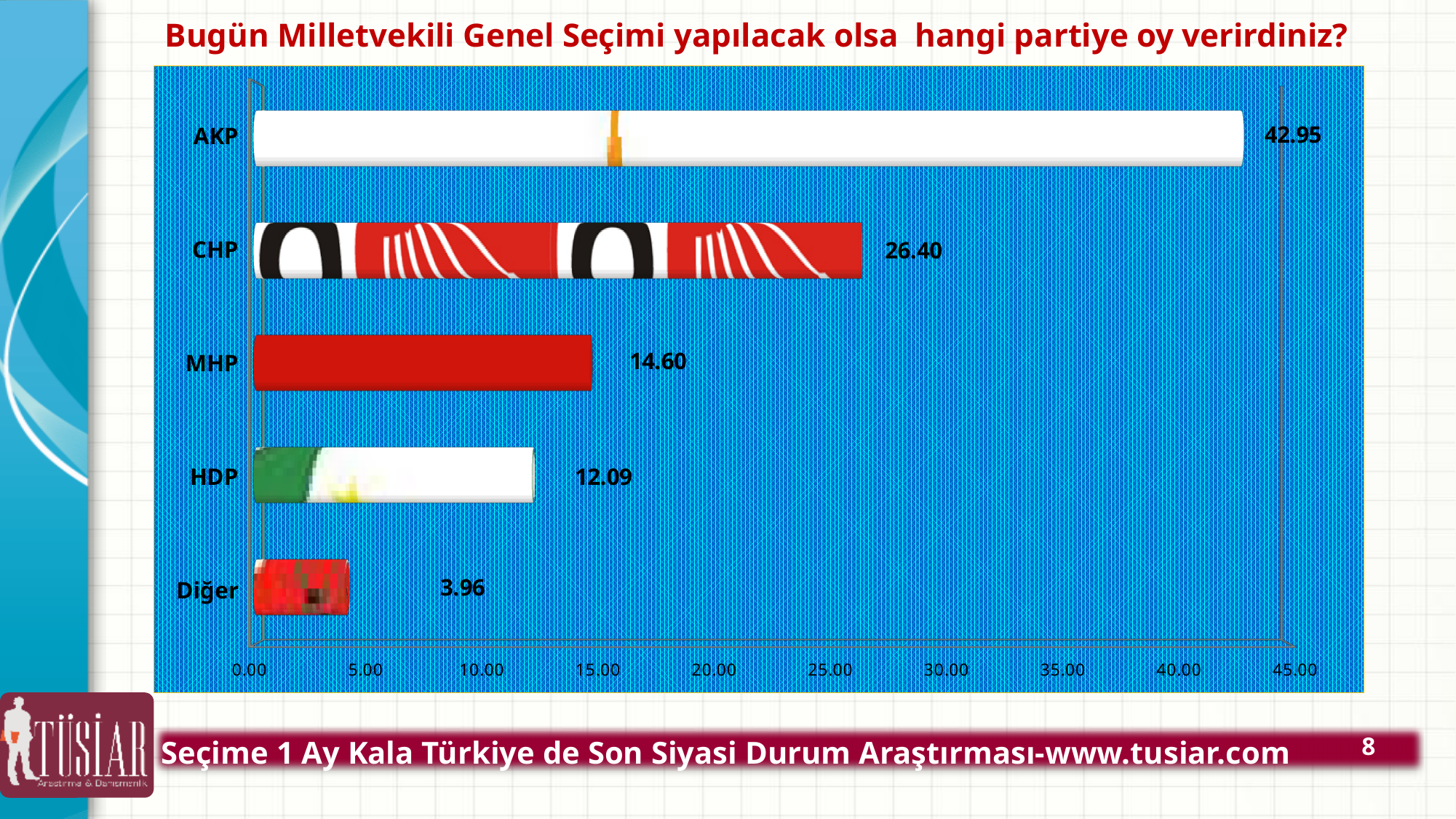
What kind of chart is shown on the slide? bar chart Which is larger, the value for MHP or the value for HDP? MHP What is the value for HDP? 12.09 Which category has the lowest value? Diğer What is the difference between the values for AKP and CHP? 16.55 What is the value for MHP? 14.60 What is the value for AKP? 42.95 What is the value for CHP? 26.40 Is the value for CHP greater or less than 25.00? greater What is the value for Diğer? 3.96 How many parties/categories are shown in the chart? 5 Which party has the highest value? AKP